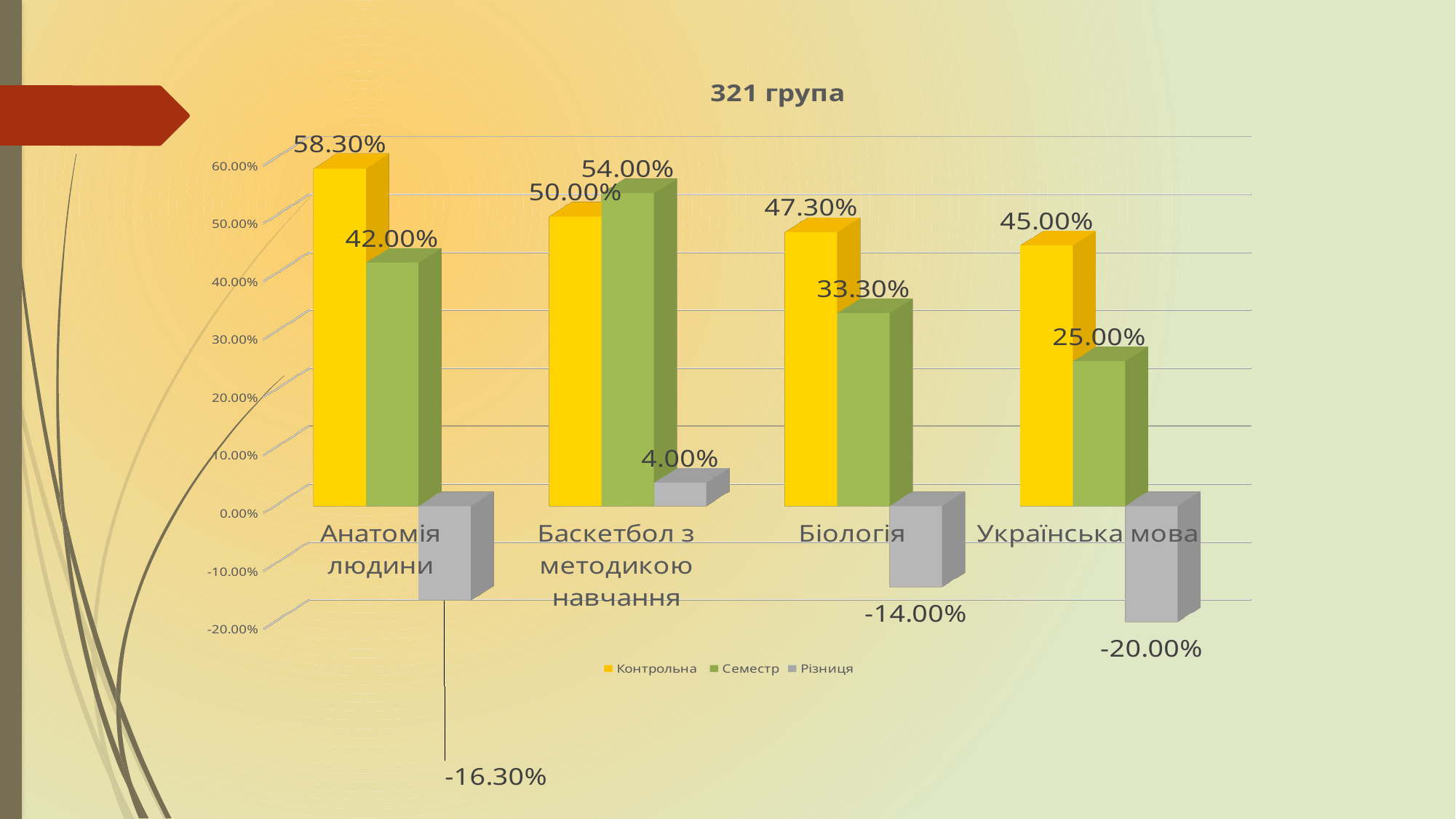
Do the Контрольна values rise or fall from left to right along the x axis? fall What is the difference between the Контрольна and Семестр values for Біологія? 14.00% What type of chart is shown on the slide? bar chart How many series does the legend list? 3 What is the Контрольна value for Анатомія людини? 58.30% Which category has the lowest Семестр value? Українська мова What is the Різниця value for Українська мова? -20.00% How many categories are shown on the x axis? 4 For Баскетбол з методикою навчання, which is larger: the Контрольна value or the Семестр value? Семестр What is the title of the chart? 321 група Which category has the highest Контрольна value? Анатомія людини What is the Семестр value for Біологія? 33.30%